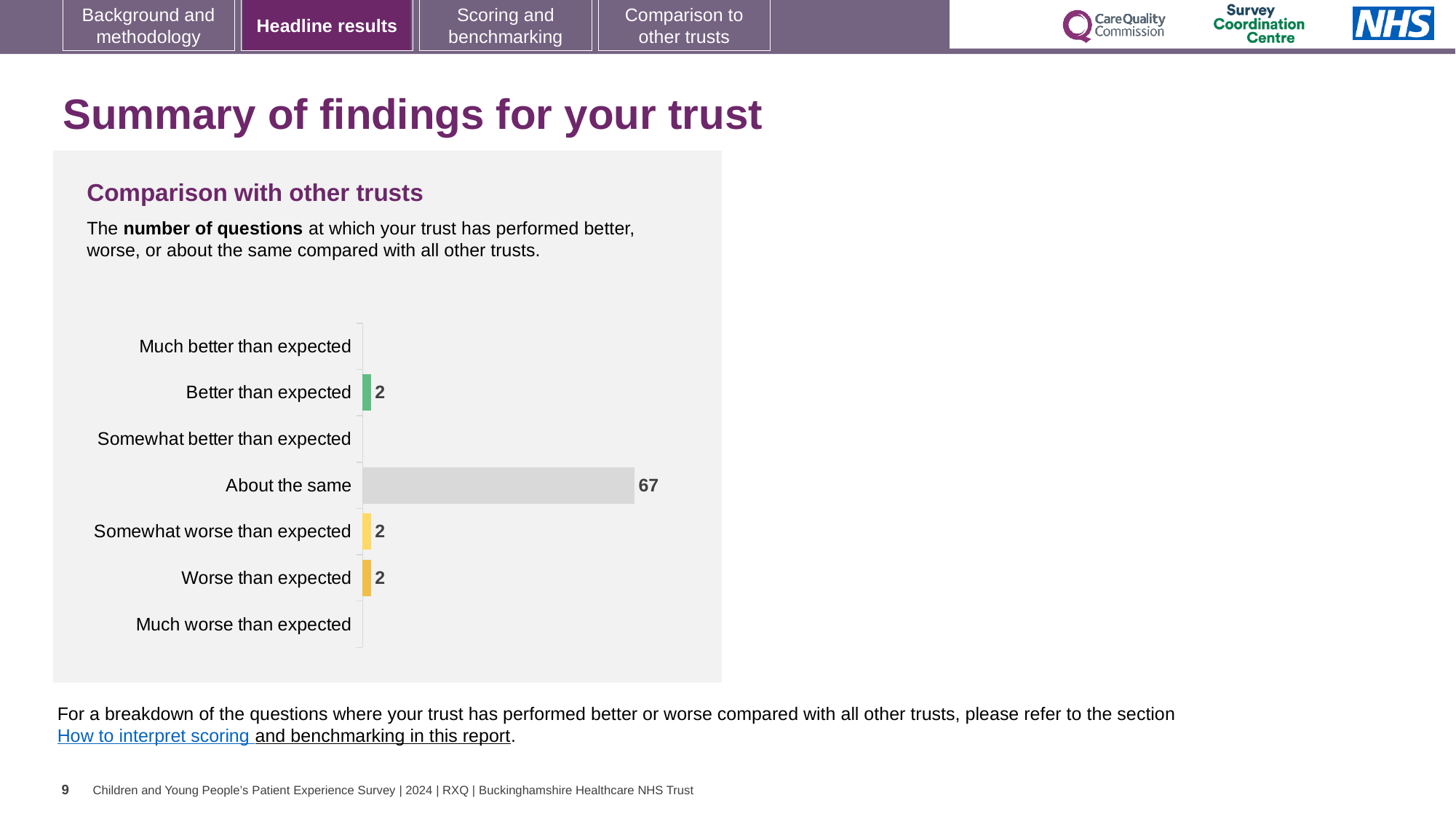
What is the value for 'Worse than expected'? 2 How many categories are listed on the chart's axis? 7 What is the value for 'Better than expected'? 2 How many categories have a labelled value of 2? 3 What colour is the bar for 'Better than expected'? Green What is the title of the chart? Comparison with other trusts What is the value for 'Somewhat worse than expected'? 2 What is the value for 'About the same'? 67 Which is larger, the value for 'About the same' or the value for 'Worse than expected'? About the same Which category has the highest value? About the same What kind of chart is shown on the slide? Bar chart What is the difference between the values for 'About the same' and 'Better than expected'? 65